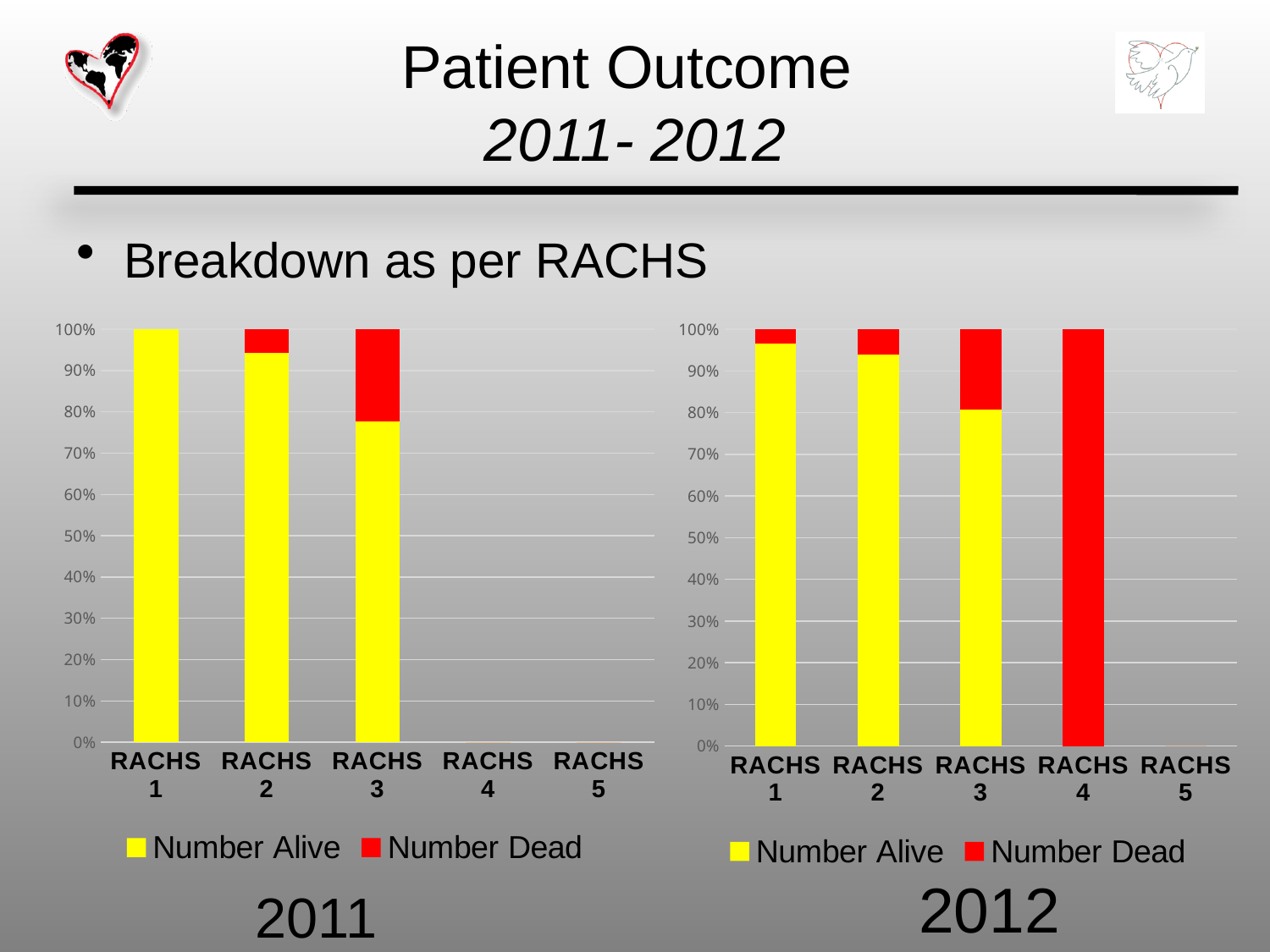
How many RACHS categories are shown on the x axis of the 2011 chart? 5 In the 2011 chart, is the Number Alive share for RACHS 2 greater or less than 90%? greater In the 2012 chart, which RACHS category has the largest Number Dead share? RACHS 4 In the 2011 chart, is the Number Alive share for RACHS 3 greater or less than 80%? less What colour represents Number Dead in the legend of the 2011 chart? red In the 2012 chart, what is the Number Dead share for RACHS 4? 100% In the 2012 chart, which of RACHS 1 or RACHS 3 has the larger Number Alive share? RACHS 1 In the 2011 chart, which of RACHS 2 or RACHS 3 has the larger Number Dead share? RACHS 3 What kind of chart is the 2011 chart on the left? stacked bar chart How many series does the legend of the 2012 chart list? 2 In the 2011 chart, what is the Number Alive share for RACHS 1? 100%